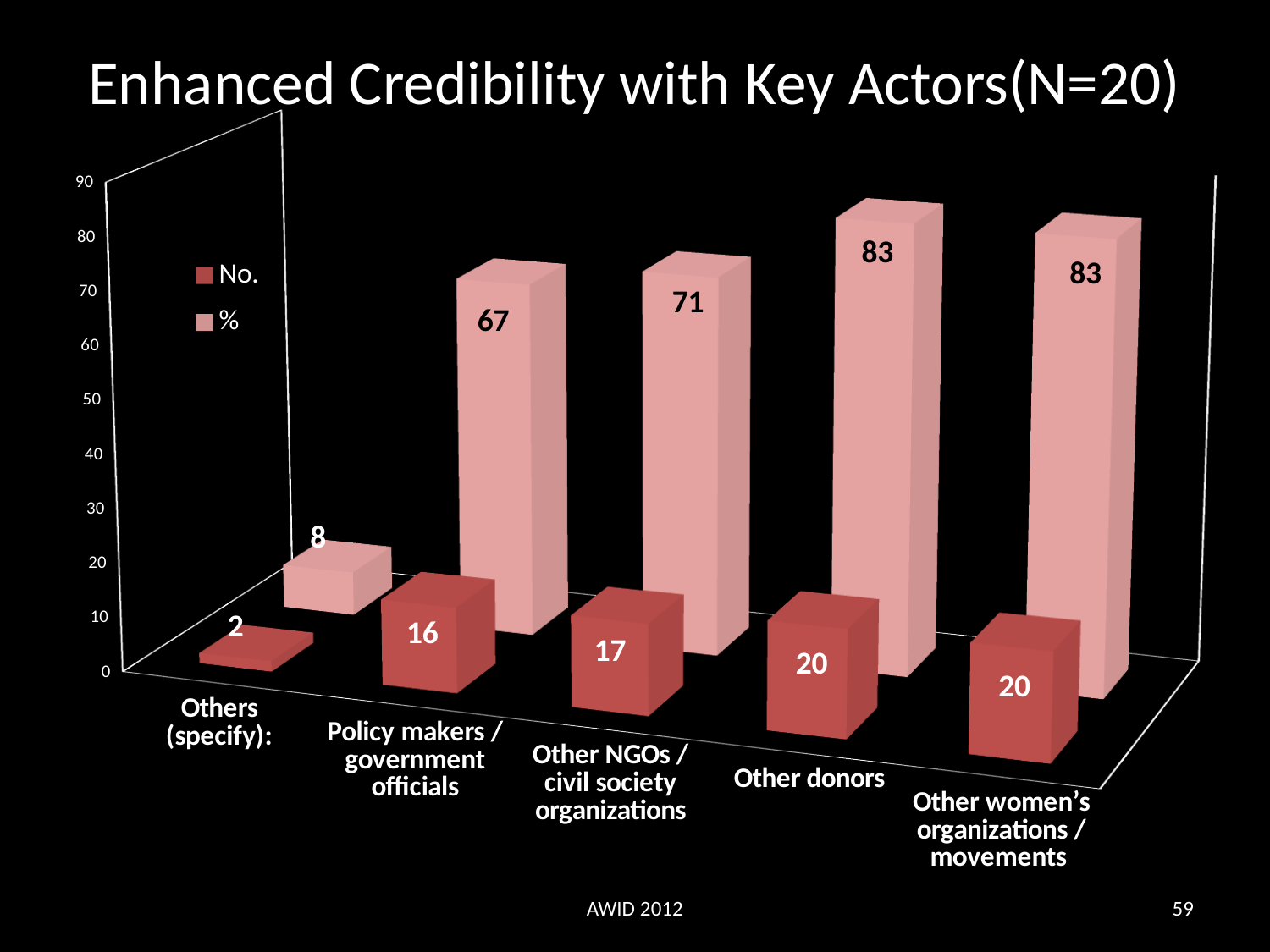
Which is larger, the % value for Other NGOs / civil society organizations or for Policy makers / government officials? Other NGOs / civil society organizations What is the % value for Other NGOs / civil society organizations? 71 What is the % value for Other donors? 83 What is the difference between the No. values for Other NGOs / civil society organizations and Others (specify):? 15 What is the No. value for Policy makers / government officials? 16 What is the No. value for Others (specify):? 2 What is the title of the chart? Enhanced Credibility with Key Actors(N=20) What is the difference between the % values for Other donors and Policy makers / government officials? 16 How many series does the legend list? 2 Which category has the lowest % value? Others (specify): What kind of chart is shown on the slide? bar chart How many categories are shown on the x axis? 5